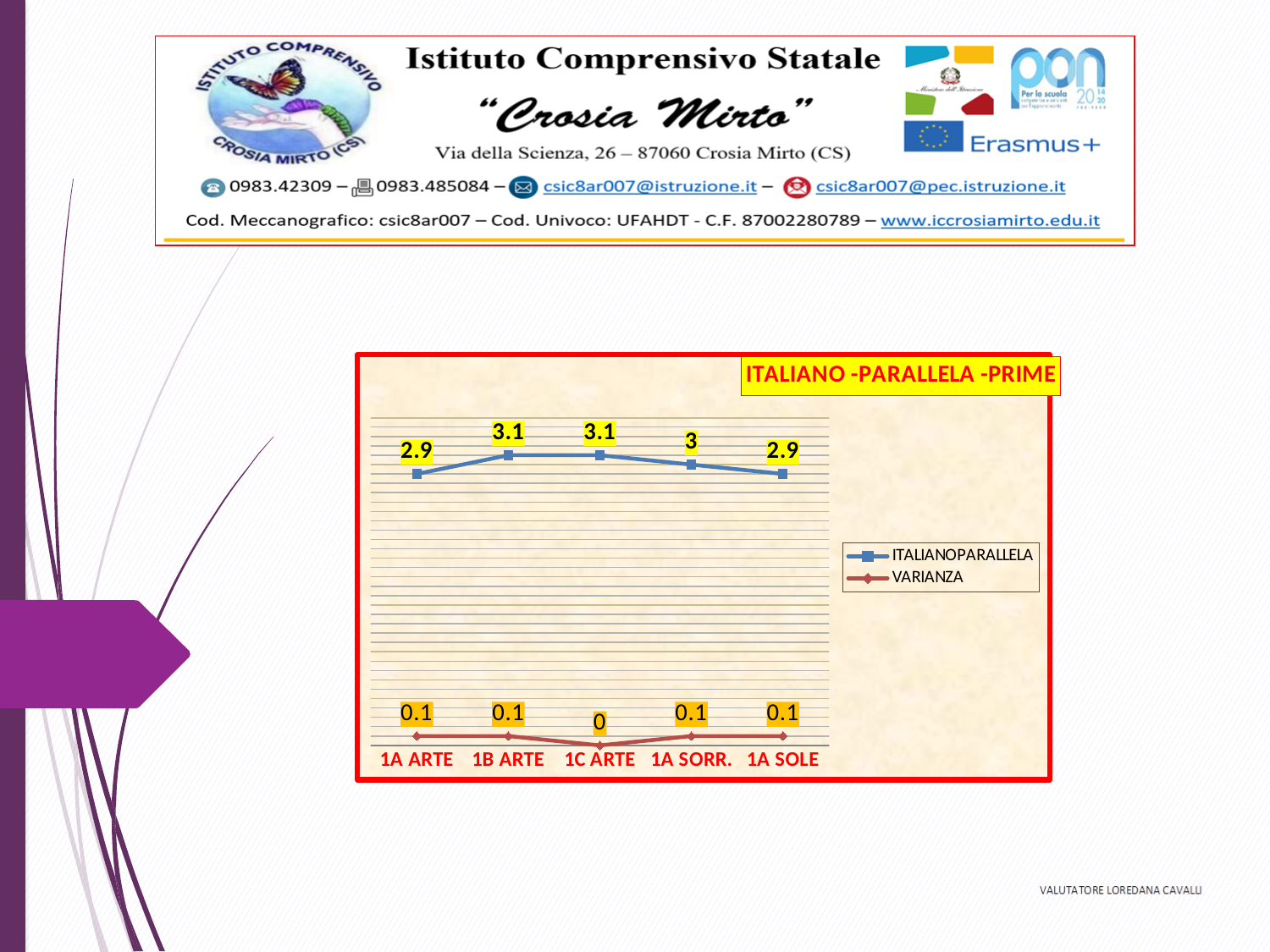
How many categories are shown on the x axis of the chart? 5 What is the ITALIANOPARALLELA value for 1A SORR.? 3 What is the title of the chart? ITALIANO -PARALLELA -PRIME What kind of chart is shown on the slide? Line chart What is the VARIANZA value for 1A SOLE? 0.1 What is the VARIANZA value for 1C ARTE? 0 How many series does the chart legend list? 2 What is the ITALIANOPARALLELA value for 1A ARTE? 2.9 Which is larger, the ITALIANOPARALLELA value for 1B ARTE or for 1A SORR.? 1B ARTE Which category has the lowest VARIANZA value? 1C ARTE What is the ITALIANOPARALLELA value for 1B ARTE? 3.1 What is the difference between the ITALIANOPARALLELA values for 1C ARTE and 1A SOLE? 0.2